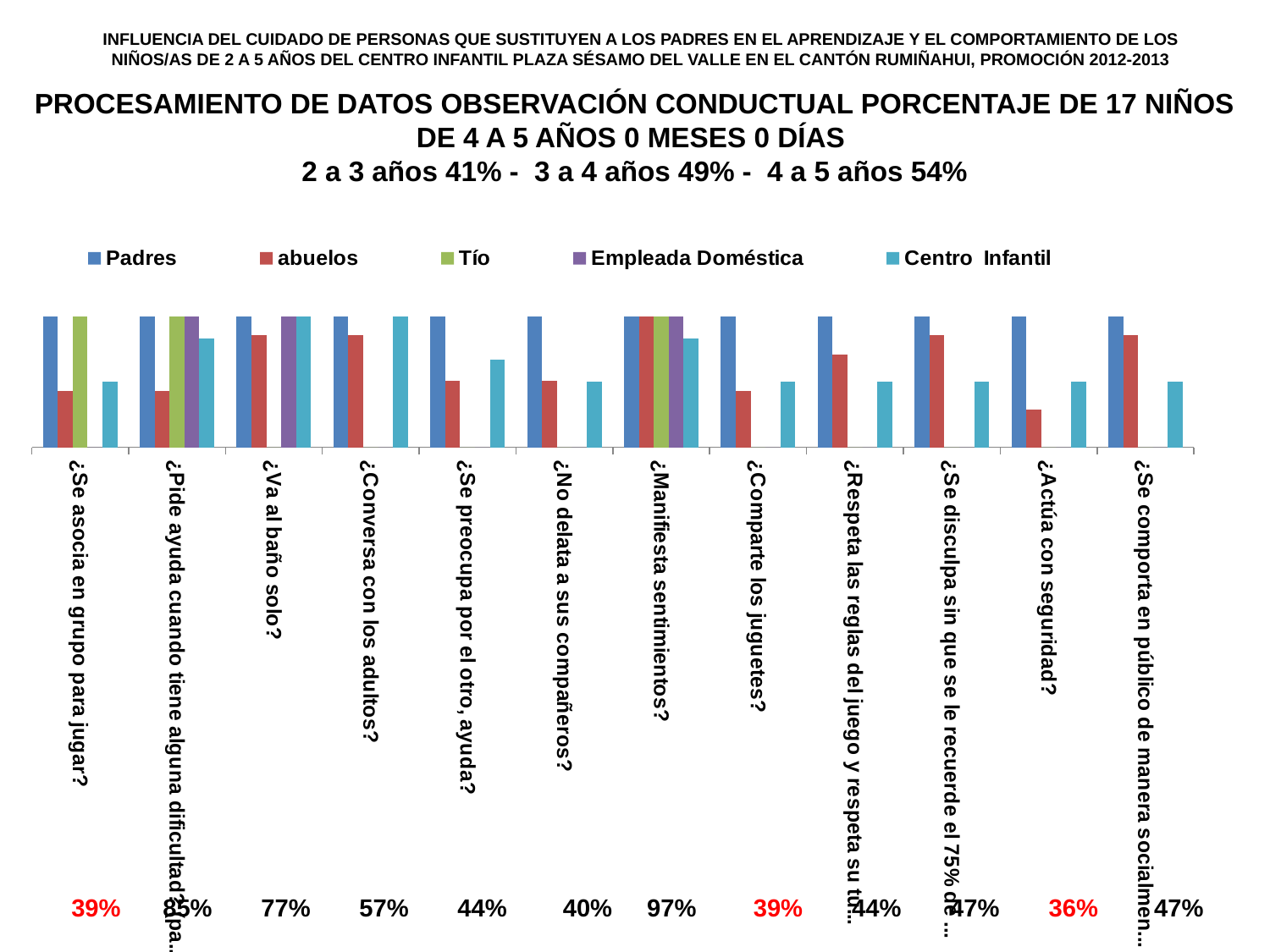
For '¿Actúa con seguridad?', which is larger, the Padres bar or the abuelos bar? Padres For '¿Va al baño solo?', which is larger, the Padres bar or the abuelos bar? Padres For '¿Se preocupa por el otro, ayuda?', which is larger, the Centro Infantil bar or the abuelos bar? Centro Infantil How many series have a visible bar for '¿Manifiesta sentimientos?'? 5 What percentage is printed beneath the category '¿Manifiesta sentimientos?'? 97% How many question categories are shown along the x axis? 12 Which series is shown in blue in the legend? Padres How many series does the legend list? 5 What kind of chart is shown on the slide? bar chart